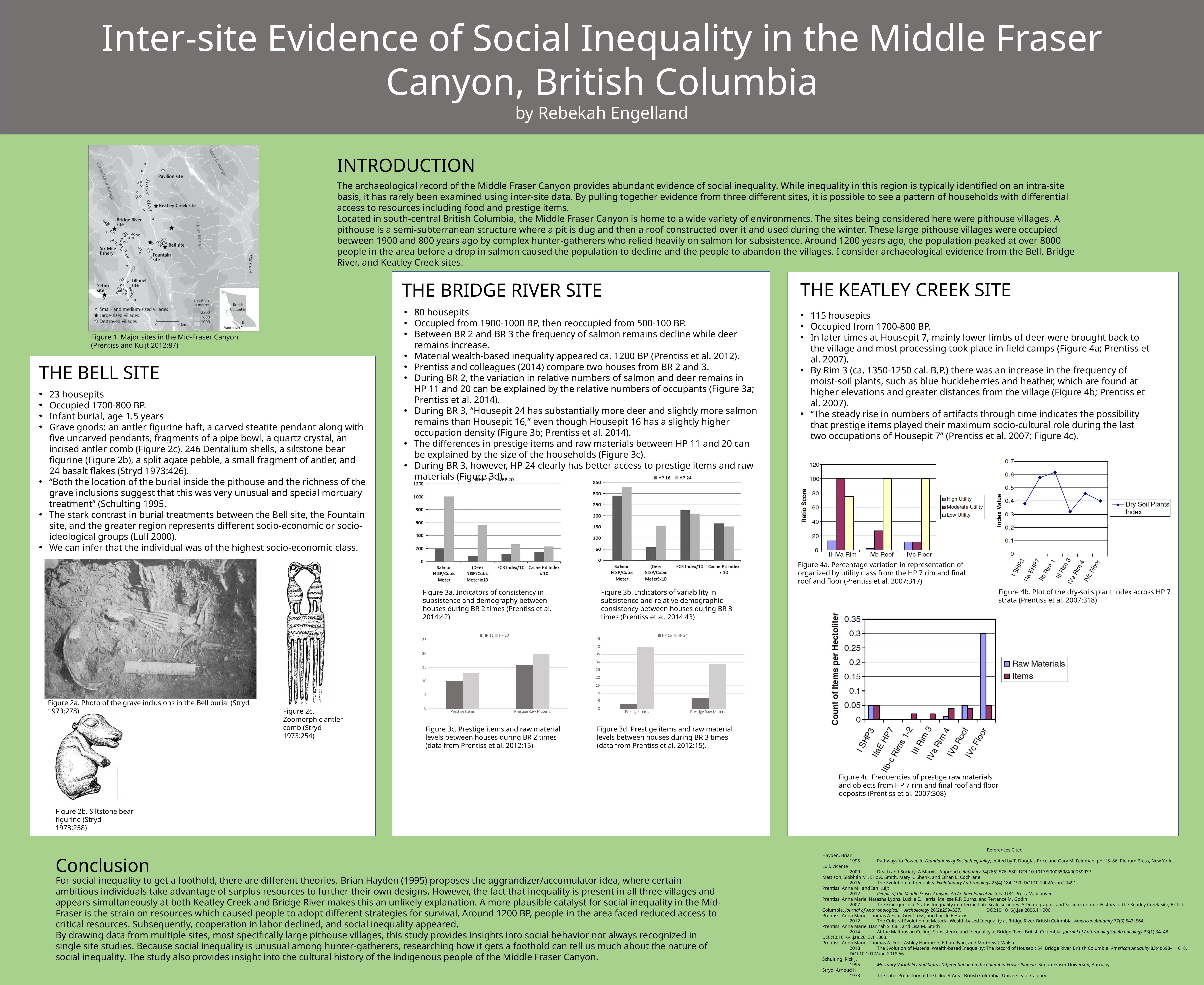
In Figure 4b (dry-soils plant index), which stratum has the highest index value? IIb Rim 1 In Figure 3c (prestige items and raw material during BR 2), what is the Prestige Raw Material value for HP 20? 20 In Figure 3a (indicators during BR 2), which house has the higher (Deer NISP/Cubic Meter)x10 value, HP 11 or HP 20? HP 20 In Figure 4c (frequencies of prestige raw materials and objects), what is the Raw Materials count per hectoliter for IVc Floor? 0.3 What kind of chart is Figure 4b (dry-soils plant index across HP 7 strata)? line chart In Figure 3b (indicators during BR 3), is the Salmon NISP/Cubic Meter value for HP 16 greater or less than 250? greater In Figure 4a (ratio score by utility class), what is the Moderate Utility ratio score for II-IVa Rim? 100 In Figure 3d (prestige items and raw material during BR 3), which house has the larger Prestige Raw Material value, HP 16 or HP 24? HP 24 In Figure 4a (ratio score by utility class), how many series does the legend list? 3 In Figure 3a (indicators during BR 2), is the Salmon NISP/Cubic Meter value for HP 11 greater or less than 400? less In Figure 3c (prestige items and raw material during BR 2), what is the Prestige Items value for HP 11? 10 In Figure 3d (prestige items and raw material during BR 3), what is the Prestige Items value for HP 24? 40